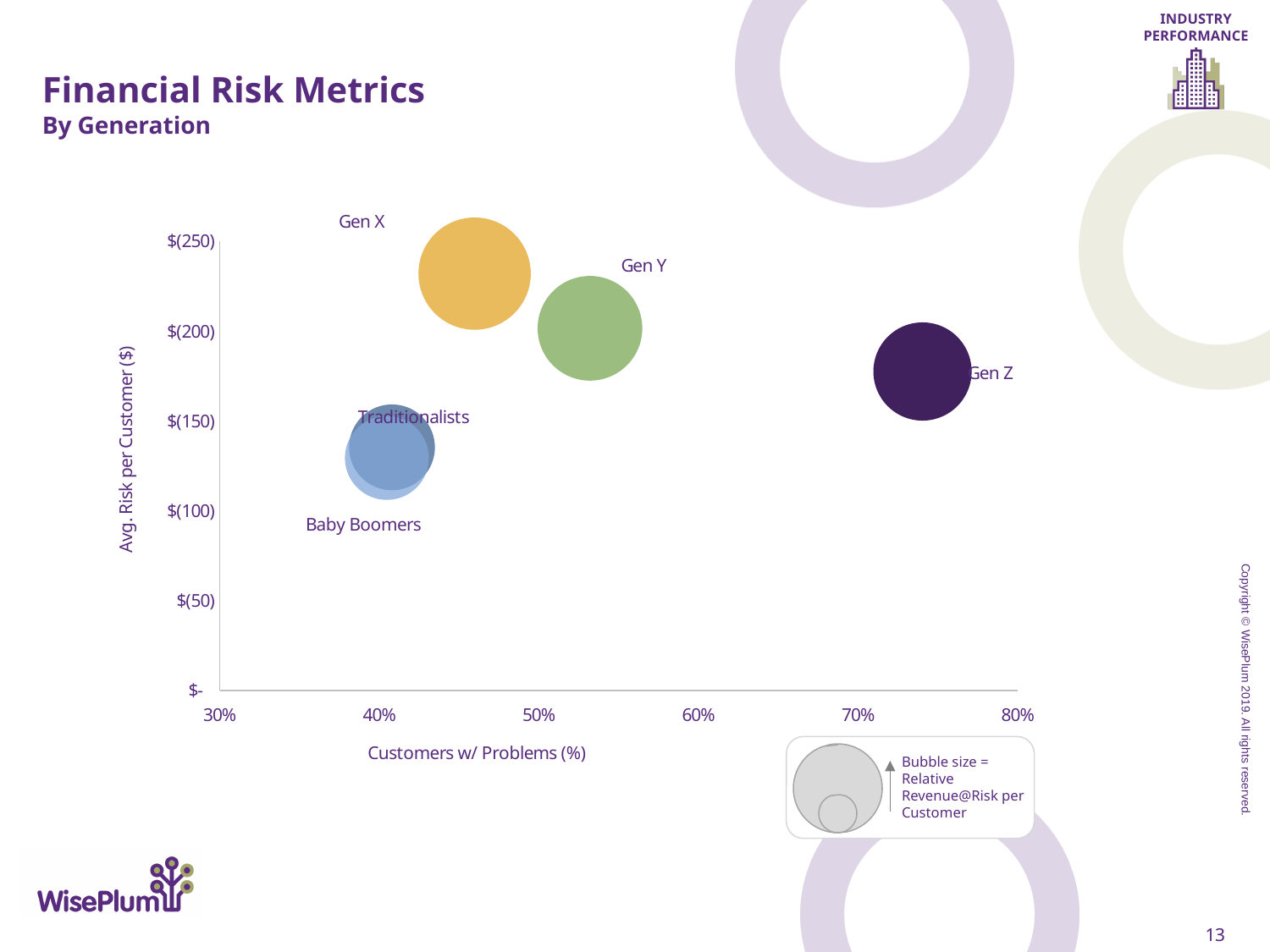
Which has a higher Customers w/ Problems (%) value, Gen X or Gen Z? Gen Z Is the Customers w/ Problems (%) value for Gen X greater or less than 50%? less Is the Avg. Risk per Customer for Gen Z greater or less than $(150)? greater What does the bubble size represent according to the chart's note? Relative Revenue@Risk per Customer Which generation has the highest Customers w/ Problems (%) value? Gen Z Which has a higher Avg. Risk per Customer, Gen Y or Traditionalists? Gen Y Is the Customers w/ Problems (%) value for Gen Z greater or less than 70%? greater What is the label of the x axis? Customers w/ Problems (%) Which generation has the highest Avg. Risk per Customer ($)? Gen X What kind of chart is shown on the slide? Bubble chart How many generation bubbles are plotted on the chart? 5